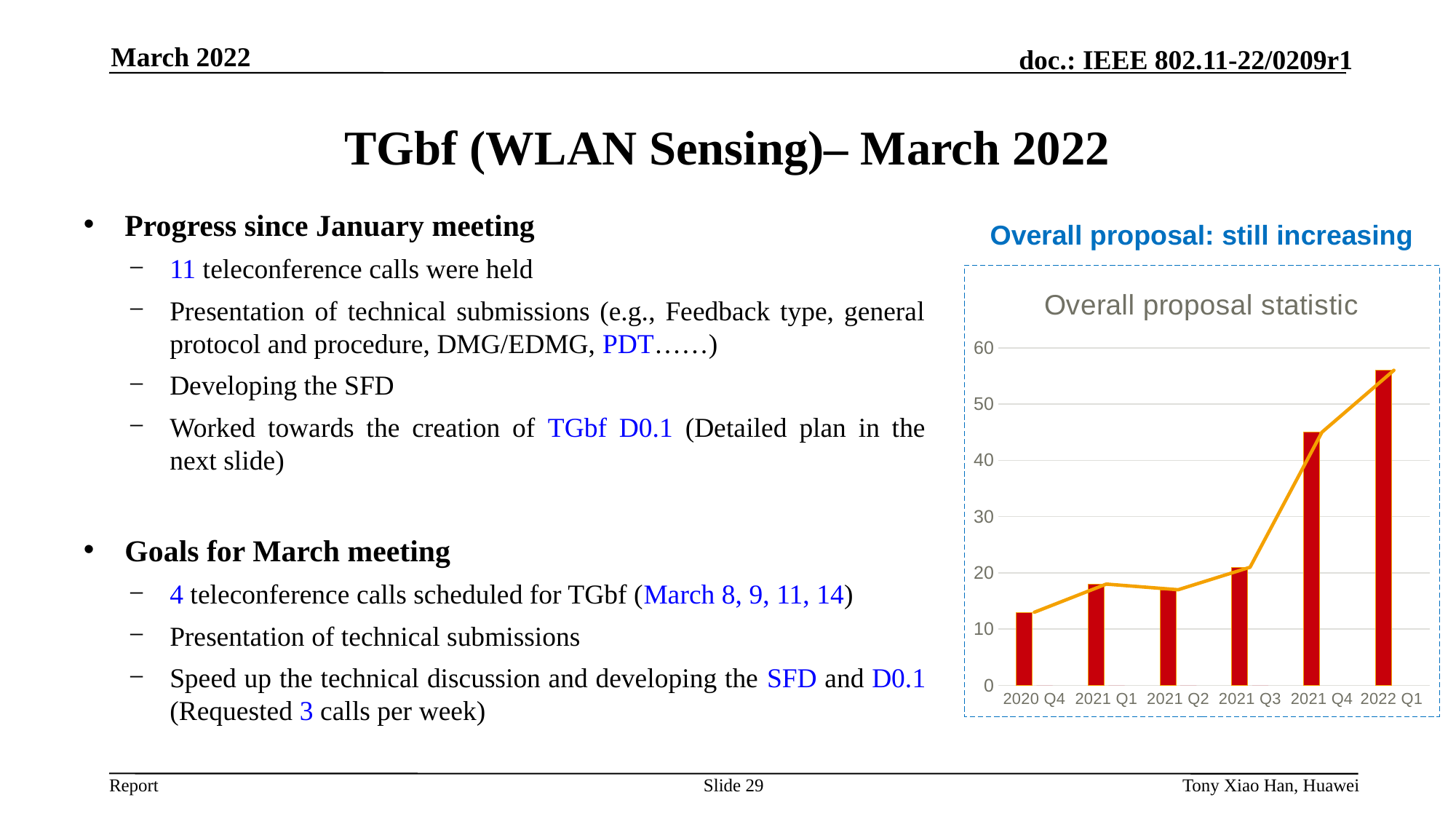
What colour are the bars in the chart? Red Do the values in the chart generally rise or fall from 2020 Q4 to 2022 Q1? Rise How many quarters are shown on the x axis of the chart? 6 What kind of chart is shown on the slide? Bar chart with a line overlay Which quarter has the highest value in the chart? 2022 Q1 Is the value for 2021 Q3 greater or less than 30? less Which quarter has the lowest value in the chart? 2020 Q4 Which is larger, the value for 2021 Q4 or the value for 2021 Q3? 2021 Q4 Is the value for 2020 Q4 greater or less than 20? less Is the value for 2021 Q4 greater or less than 40? greater What is the title of the chart on the slide? Overall proposal statistic